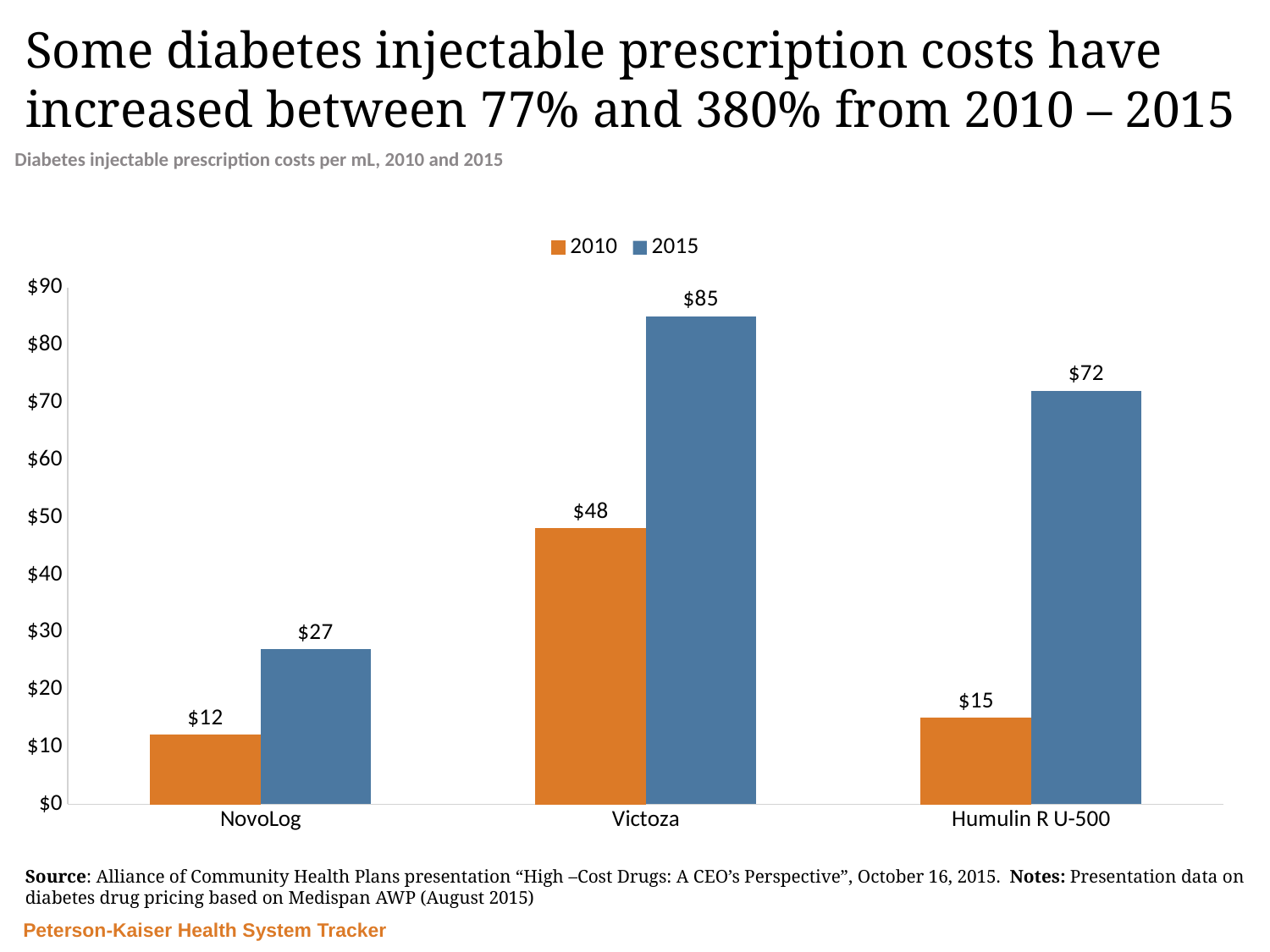
How many series does the legend list? 2 How many drugs are shown on the x axis? 3 What is the difference between the 2015 cost per mL for Victoza and NovoLog? $58 Which drug had the highest 2015 cost per mL? Victoza What is the difference between the 2015 and 2010 cost per mL for Humulin R U-500? $57 What was the 2015 cost per mL for Victoza? $85 Which is larger: the 2015 cost for NovoLog or the 2010 cost for Victoza? 2010 cost for Victoza What was the 2010 cost per mL for NovoLog? $12 Is the 2015 cost per mL for Humulin R U-500 greater or less than $60? greater What kind of chart is shown on the slide? Bar chart Which drug had the lowest 2010 cost per mL? NovoLog What was the 2010 cost per mL for Humulin R U-500? $15